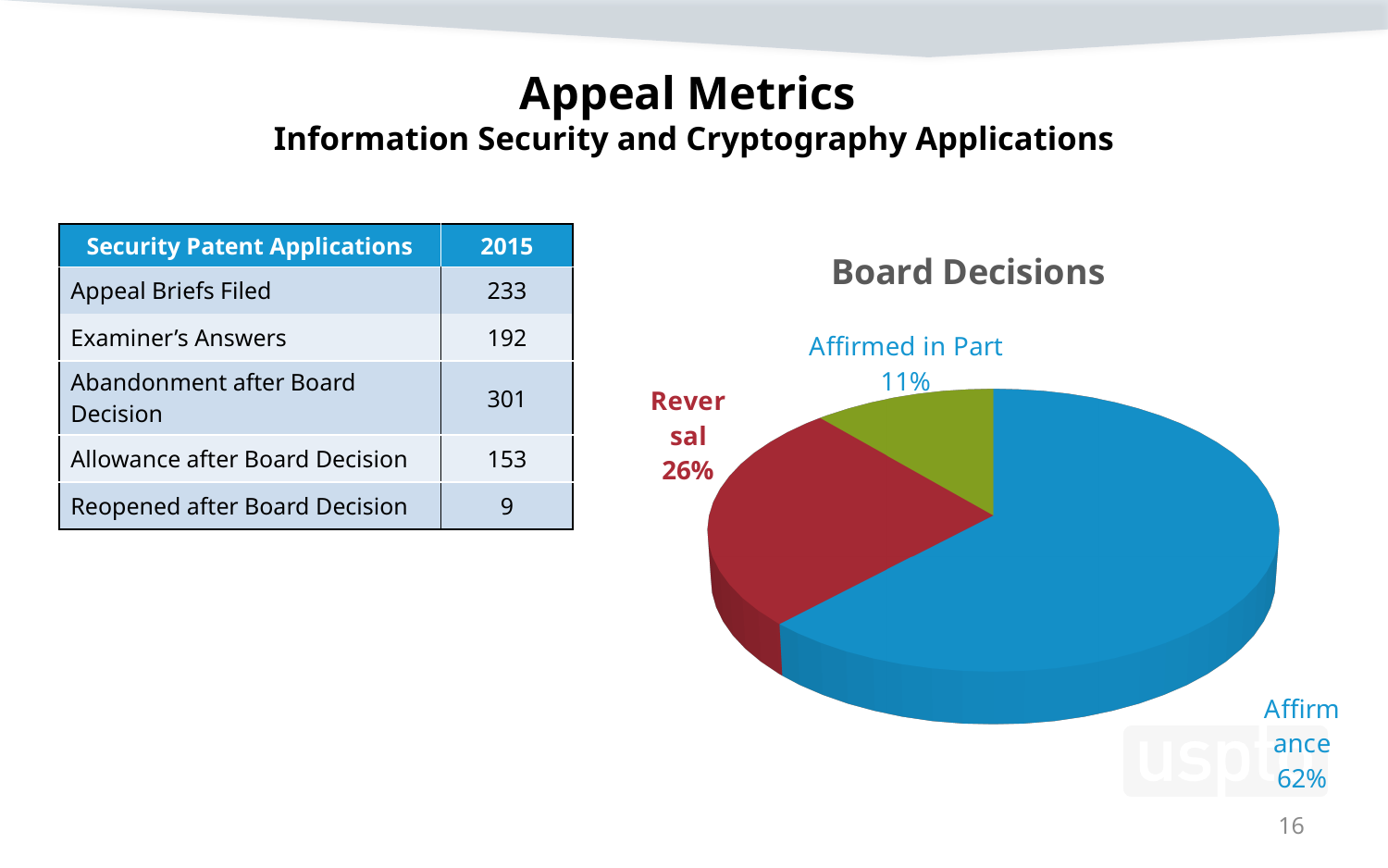
What share of the Board Decisions pie is Reversal? 26% Which slice of the Board Decisions pie is the largest? Affirmance Which slice of the Board Decisions pie is the smallest? Affirmed in Part What is the difference in percentage points between the Reversal and Affirmed in Part slices of the Board Decisions pie? 15 What is the title of the chart on the slide? Board Decisions What kind of chart is shown on the slide? Pie chart What colour is the Reversal slice in the Board Decisions pie chart? Red How many slices does the Board Decisions pie chart have? 3 What share of the Board Decisions pie is Affirmed in Part? 11% What is the difference in percentage points between the Affirmance and Reversal slices of the Board Decisions pie? 36 In the Board Decisions pie, which is larger: Reversal or Affirmed in Part? Reversal What share of the Board Decisions pie is Affirmance? 62%